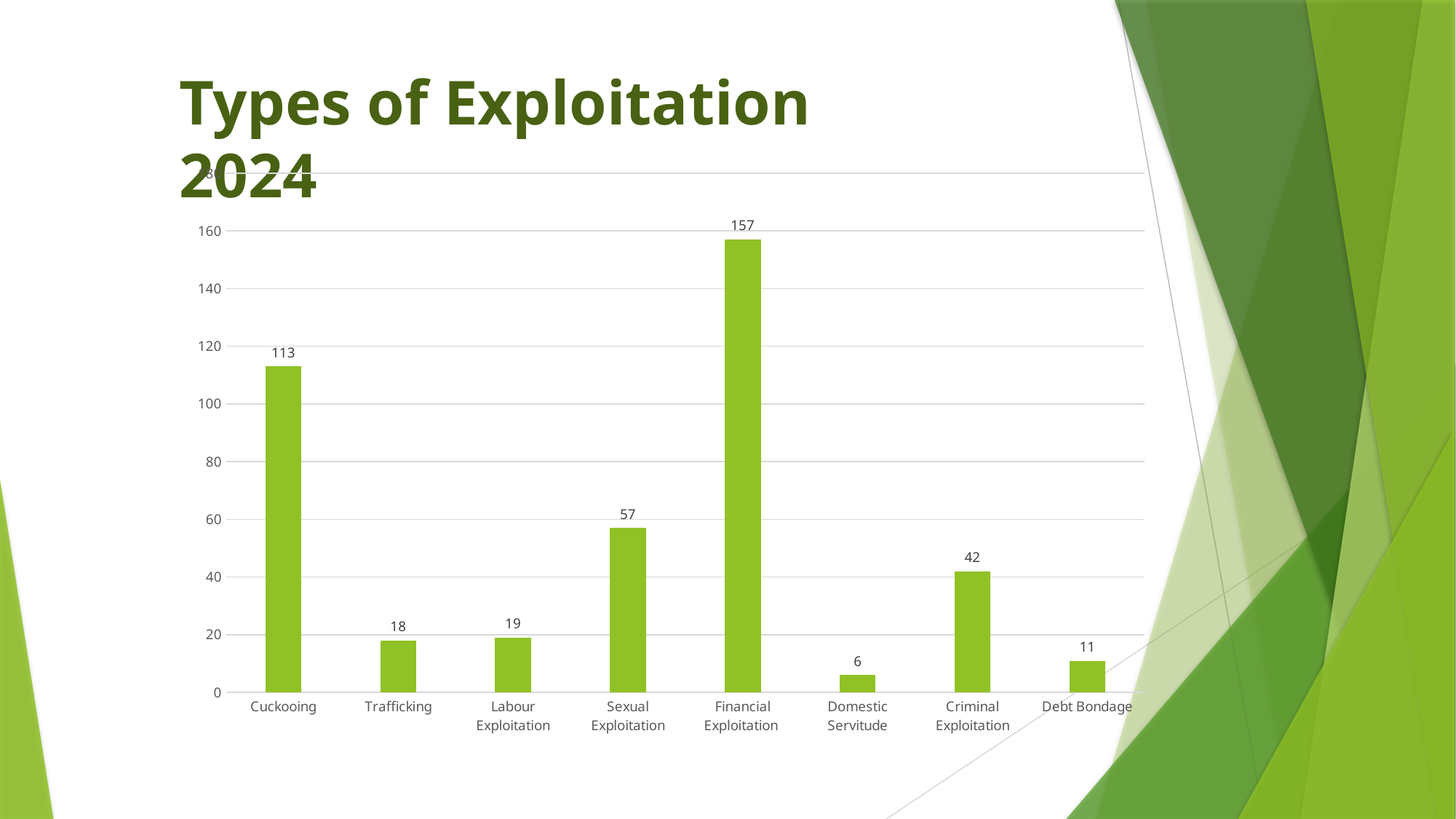
Which is larger, the value for Trafficking or the value for Criminal Exploitation? Criminal Exploitation What is the value for Debt Bondage? 11 Which category has the lowest value? Domestic Servitude What kind of chart is shown on the slide? Bar chart What is the value for Domestic Servitude? 6 What is the value for Cuckooing? 113 What is the value for Financial Exploitation? 157 What is the difference between the values for Sexual Exploitation and Criminal Exploitation? 15 Which category has the highest value? Financial Exploitation What is the difference between the values for Financial Exploitation and Cuckooing? 44 How many categories are shown on the x axis? 8 Is the value for Sexual Exploitation greater or less than 40? greater